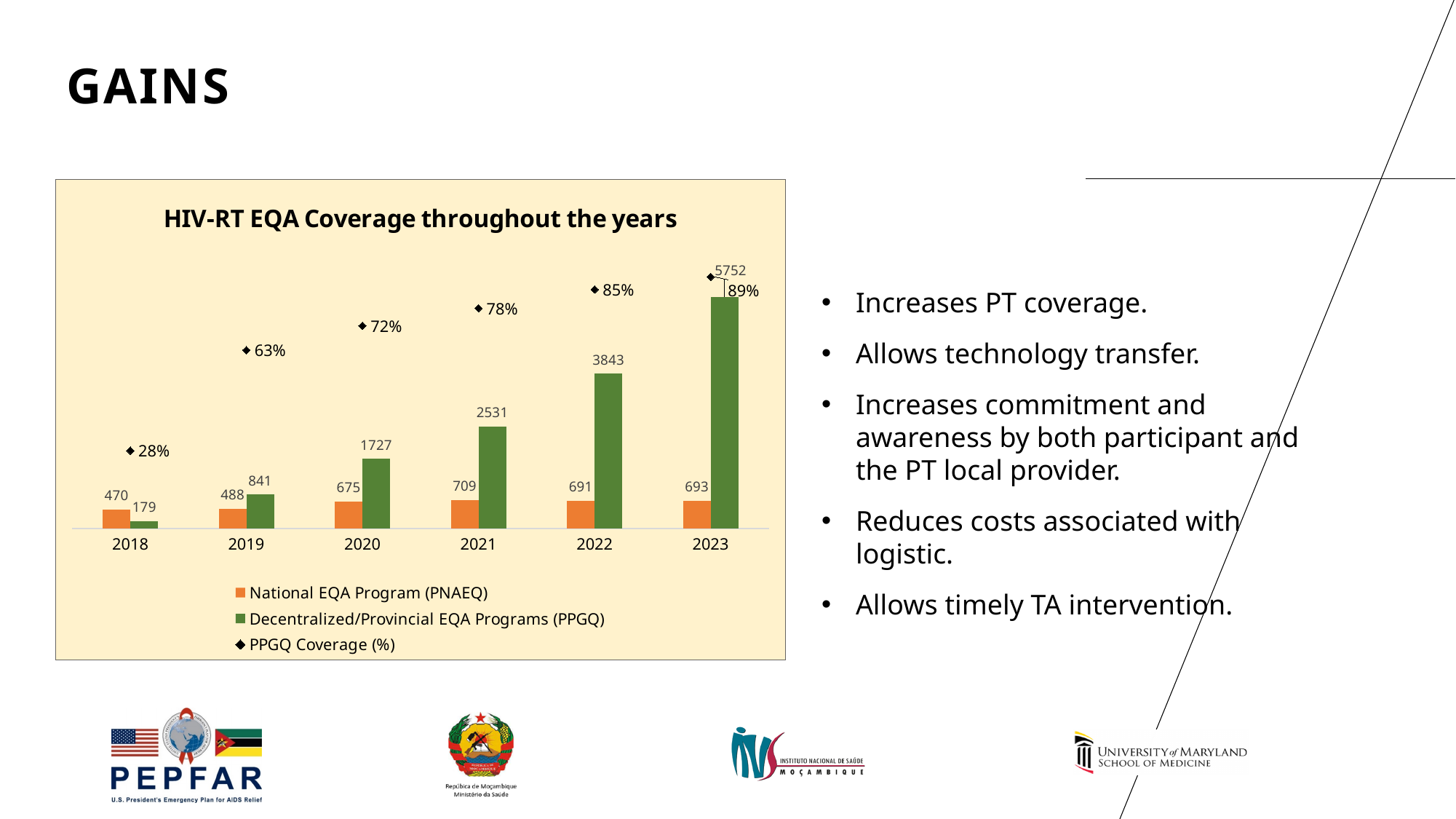
How many years are shown on the x axis? 6 What is the value for the Decentralized/Provincial EQA Programs (PPGQ) in 2023? 5752 Which year has the highest value for the Decentralized/Provincial EQA Programs (PPGQ)? 2023 How many series does the legend list? 3 What is the value for the National EQA Program (PNAEQ) in 2018? 470 Which year has the lowest PPGQ Coverage (%)? 2018 Does the PPGQ Coverage (%) rise or fall from 2018 to 2023? Rises What is the PPGQ Coverage (%) in 2020? 72% What kind of chart is used for the National EQA Program (PNAEQ) and PPGQ series? Bar chart What is the title of the chart? HIV-RT EQA Coverage throughout the years What is the difference between the PPGQ value in 2022 and the PPGQ value in 2021? 1312 Which is larger in 2019: the National EQA Program (PNAEQ) value or the Decentralized/Provincial EQA Programs (PPGQ) value? Decentralized/Provincial EQA Programs (PPGQ)